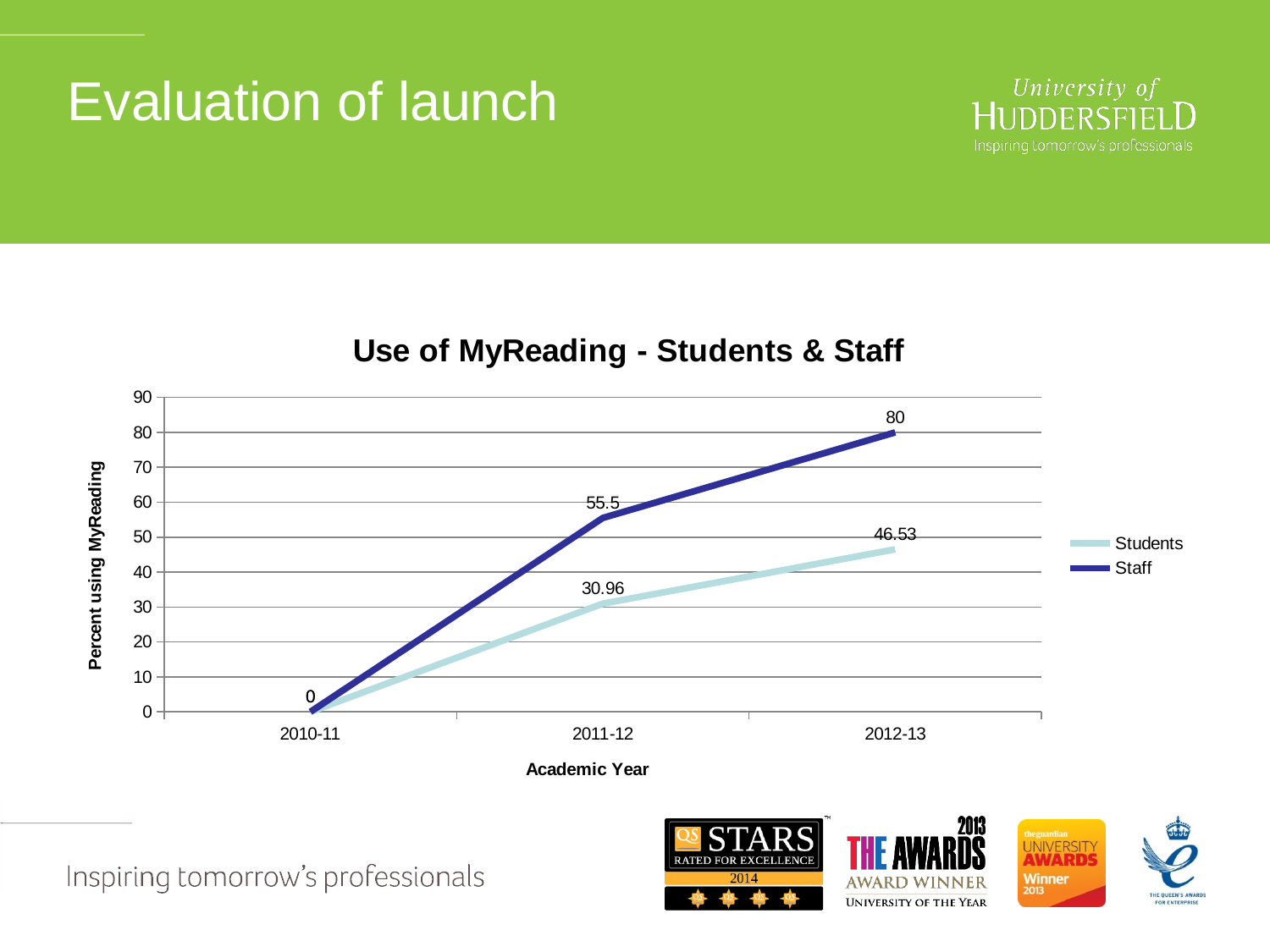
How many series does the legend list? 2 What is the value for Staff in 2011-12? 55.5 What is the value for Students in 2011-12? 30.96 Which is larger in 2011-12, the Staff value or the Students value? Staff In which academic year is the Staff value highest? 2012-13 In which academic year is the Students value lowest? 2010-11 What is the difference between the Staff and Students values in 2012-13? 33.47 Do the Students values rise or fall from 2010-11 to 2012-13? Rise How many academic years are shown on the x axis? 3 What is the value for Students in 2012-13? 46.53 What kind of chart is shown on the slide? Line chart What is the value for Staff in 2012-13? 80